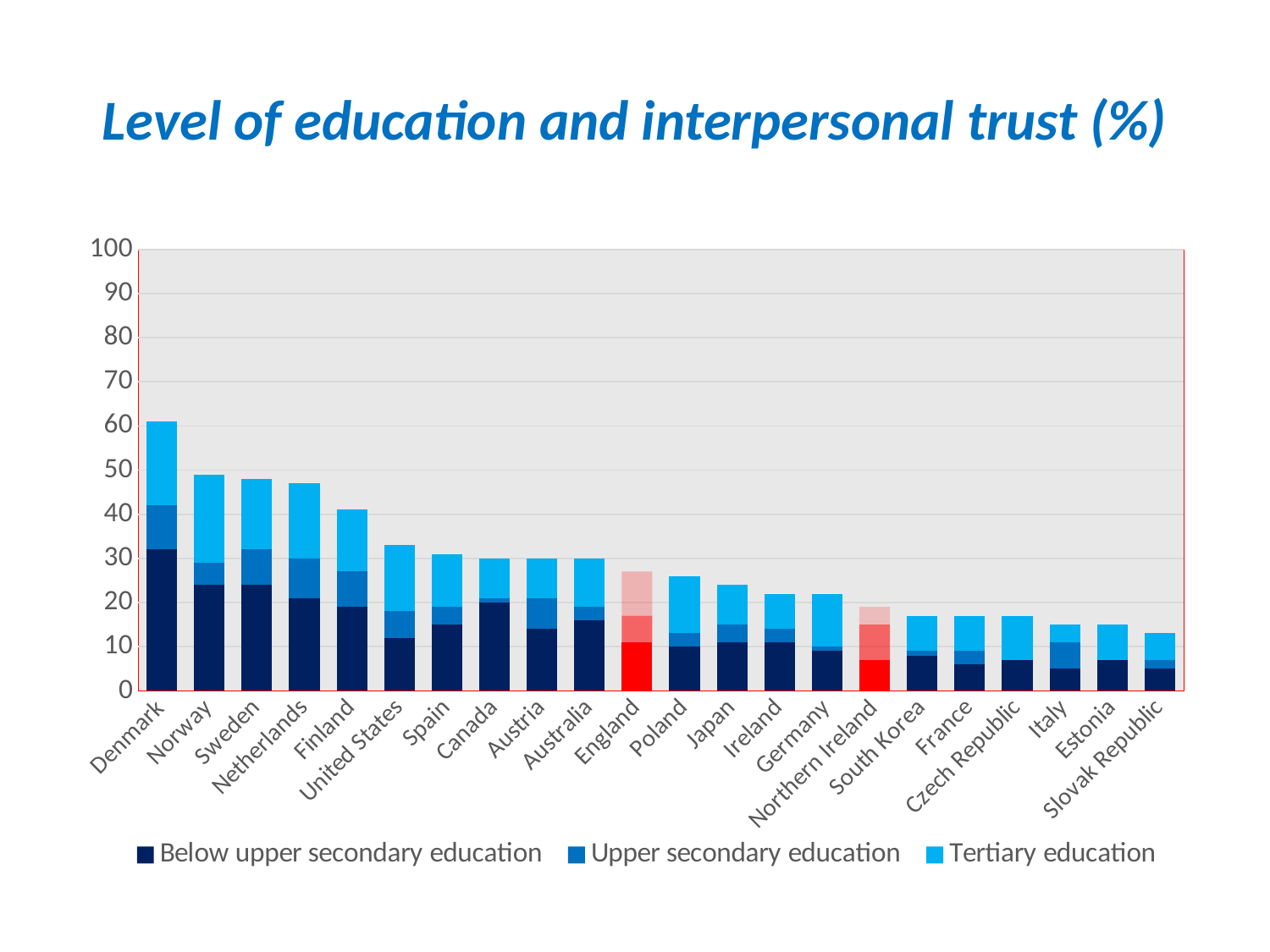
Which country has the lowest total bar? Slovak Republic How many series does the legend list? 3 Which has the larger total bar, England or Northern Ireland? England Is the total bar for Denmark greater or less than 50? greater Is the total bar for Slovak Republic greater or less than 20? less What kind of chart is shown on the slide? Stacked bar chart What is the title of the chart? Level of education and interpersonal trust (%) Is the total bar for United States greater or less than 30? greater Which two countries have their bars coloured red instead of blue? England and Northern Ireland Do the total bar heights rise or fall from left to right along the x axis? Fall Which country has the highest total bar? Denmark How many countries are shown on the x axis of the chart? 22